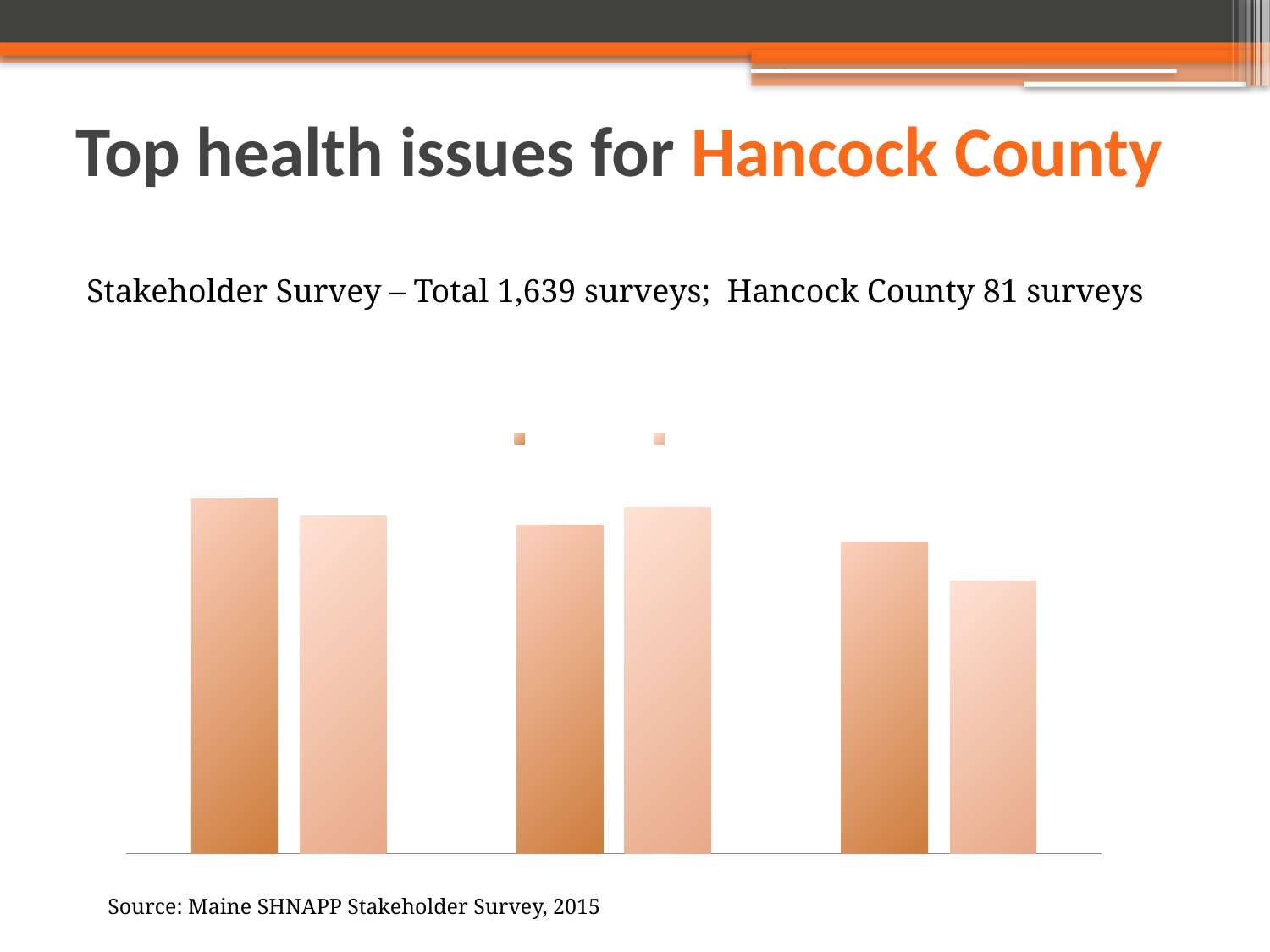
Do the darker bars rise or fall from left to right across the three groups? fall In the middle group of bars, is the darker bar or the lighter bar taller? the lighter bar What is the title of the slide containing the chart? Top health issues for Hancock County How many groups of bars are plotted in the chart? 3 How many series does the chart's legend list? 2 What kind of chart is shown on the slide? bar chart How many bars are plotted in the chart in total? 6 What source is cited below the chart? Maine SHNAPP Stakeholder Survey, 2015 In the leftmost group of bars, is the darker bar or the lighter bar taller? the darker bar Which group of bars contains the tallest bar in the chart? the leftmost group Which group of bars contains the shortest bar in the chart? the rightmost group In the rightmost group of bars, is the darker bar or the lighter bar taller? the darker bar